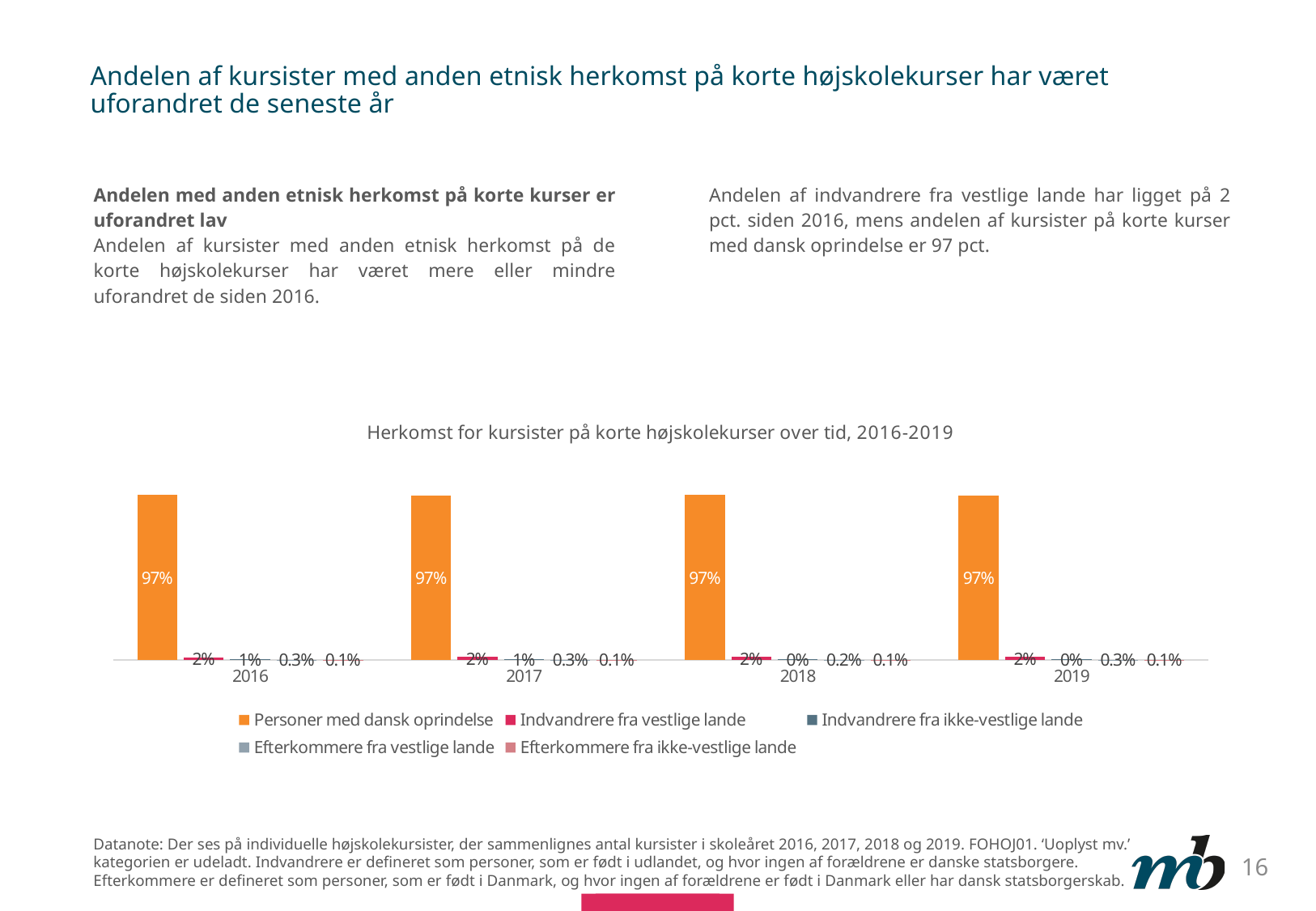
What is the difference between the value for 'Personer med dansk oprindelse' and 'Indvandrere fra vestlige lande' in 2016? 95% What kind of chart is shown on the slide? Bar chart What is the title of the chart? Herkomst for kursister på korte højskolekurser over tid, 2016-2019 How many series does the chart's legend list? 5 What is the value for 'Personer med dansk oprindelse' in 2018? 97% What is the value for 'Efterkommere fra vestlige lande' in 2018? 0.2% What is the value for 'Indvandrere fra ikke-vestlige lande' in 2016? 1% What is the value for 'Efterkommere fra ikke-vestlige lande' in 2017? 0.1% What is the value for 'Indvandrere fra vestlige lande' in 2019? 2% How many years are shown on the x axis of the chart? 4 Which series has the highest value in 2017? Personer med dansk oprindelse Does the value for 'Personer med dansk oprindelse' rise, fall or stay the same from 2016 to 2019? Stays the same